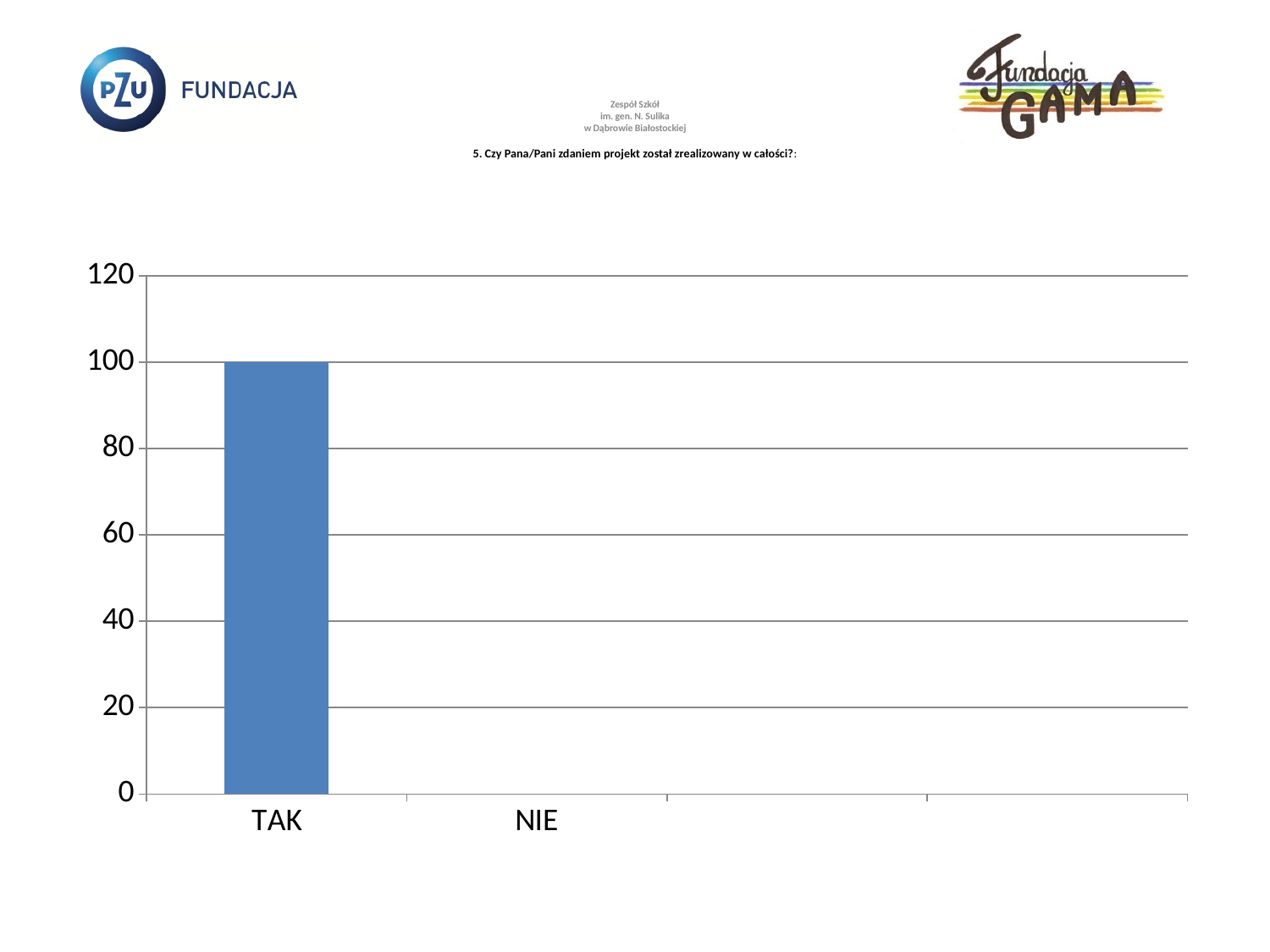
What is the difference between the values for TAK and NIE? 100 Which is larger, the value for TAK or the value for NIE? TAK Is the value for TAK greater or less than 80? greater What is the highest value shown on the y axis? 120 How many categories are labelled on the x axis? 2 What kind of chart is shown on the slide? bar chart What is the value for NIE? 0 What is the value for TAK? 100 Which category has the highest value? TAK What colour is the bar for TAK? blue Which category has the lowest value? NIE Is the value for TAK greater or less than 120? less